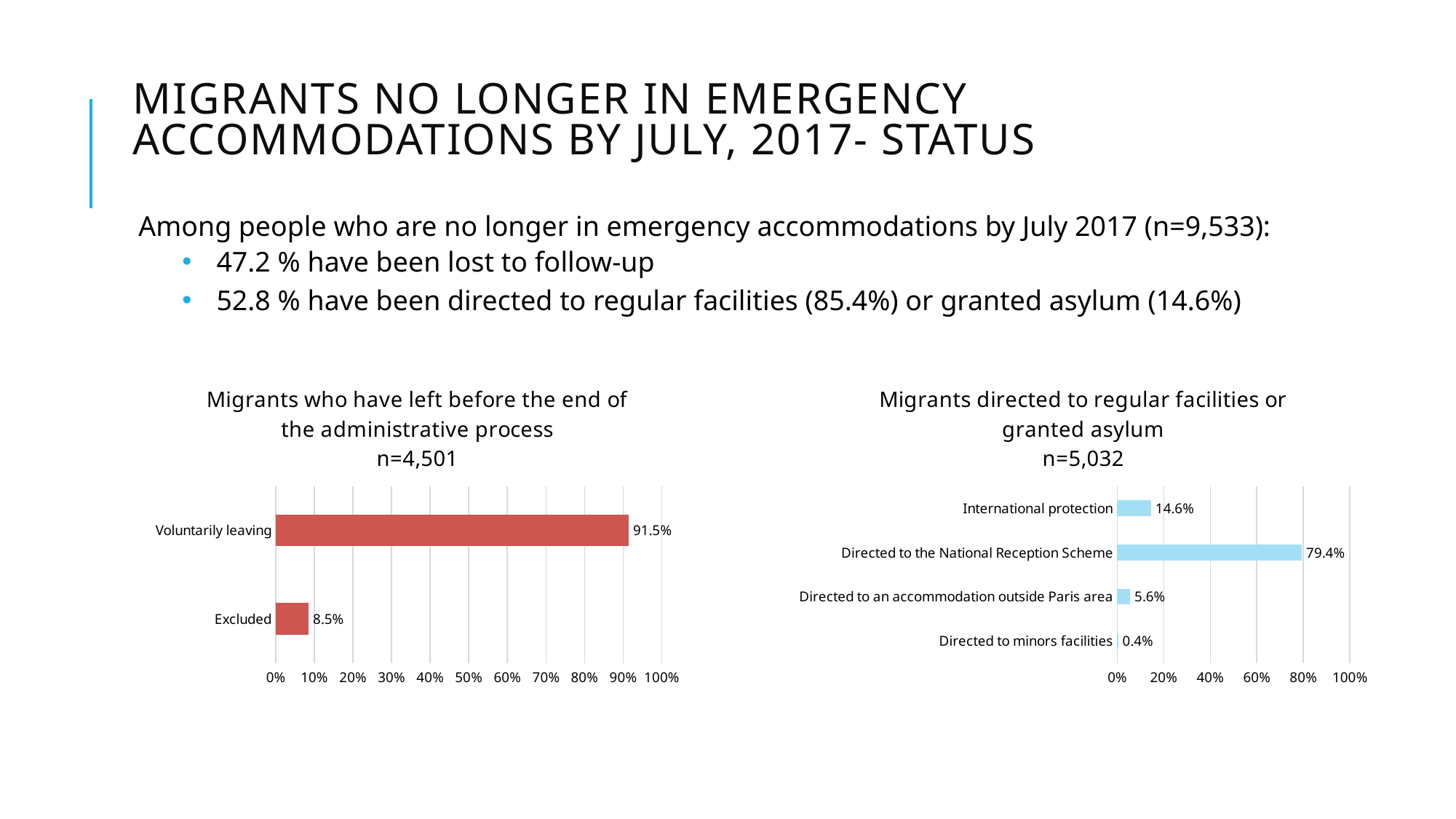
In the right chart (Migrants directed to regular facilities or granted asylum), which category has the highest value? Directed to the National Reception Scheme In the right chart (Migrants directed to regular facilities or granted asylum), which category has the lowest value? Directed to minors facilities In the left chart (Migrants who have left before the end of the administrative process), what is the value for Voluntarily leaving? 91.5% In the left chart (Migrants who have left before the end of the administrative process), what is the value for Excluded? 8.5% In the right chart (Migrants directed to regular facilities or granted asylum), how many categories are shown? 4 In the right chart (Migrants directed to regular facilities or granted asylum), what is the value for Directed to minors facilities? 0.4% In the right chart (Migrants directed to regular facilities or granted asylum), what is the value for International protection? 14.6% In the right chart (Migrants directed to regular facilities or granted asylum), which is larger: International protection or Directed to an accommodation outside Paris area? International protection In the left chart (Migrants who have left before the end of the administrative process), what is the difference between Voluntarily leaving and Excluded? 83.0 percentage points What type of chart is the left chart (Migrants who have left before the end of the administrative process)? Bar chart In the right chart (Migrants directed to regular facilities or granted asylum), what is the value for Directed to the National Reception Scheme? 79.4% In the left chart (Migrants who have left before the end of the administrative process), how many categories are shown? 2